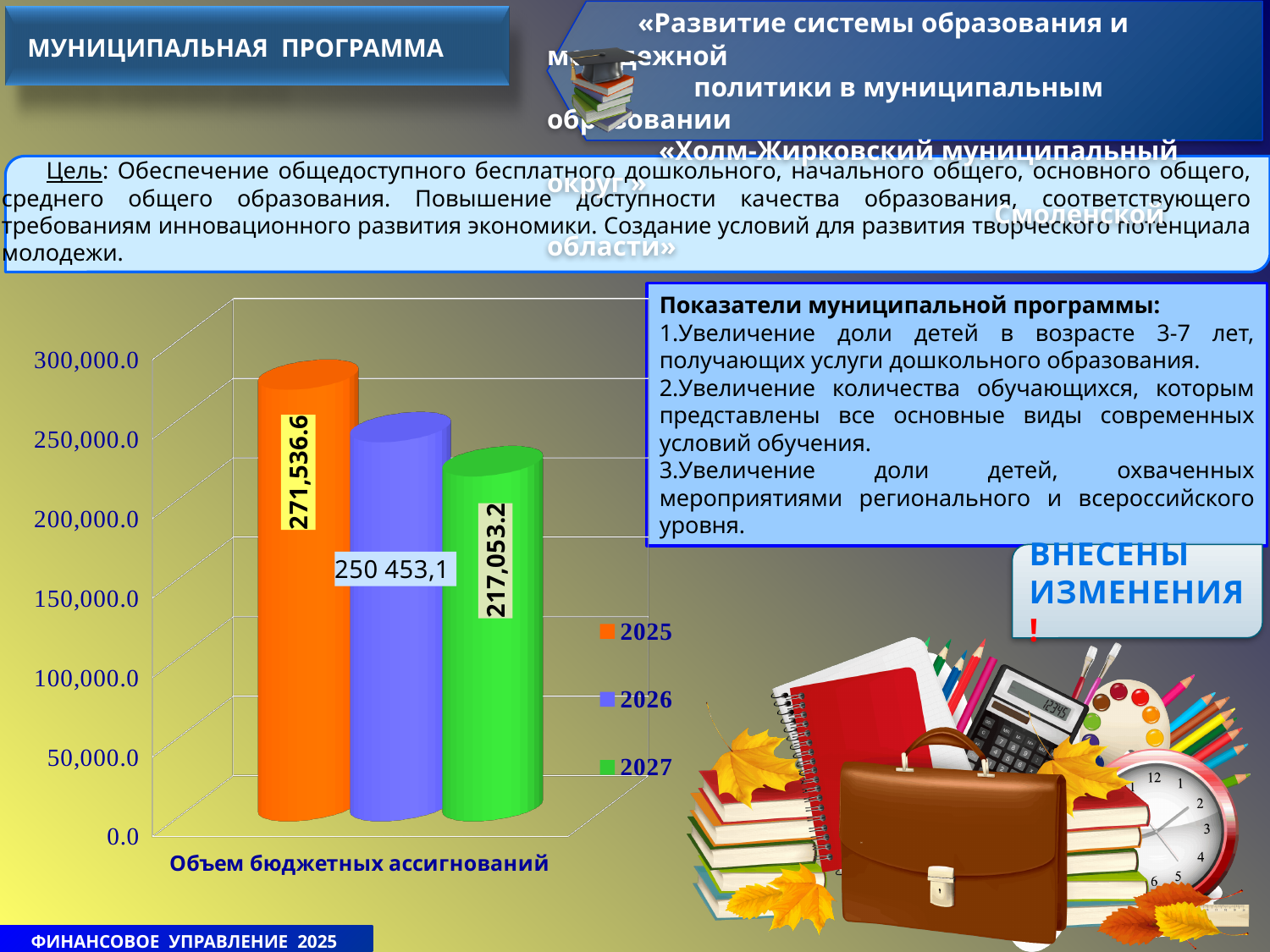
What kind of chart is shown on the slide? bar chart What is the value for 2025 in the chart? 271,536.6 Which is larger, the value for 2026 or the value for 2027? 2026 Do the values rise or fall from 2025 to 2027? fall What is the difference between the values for 2025 and 2026? 21,083.5 What is the difference between the values for 2025 and 2027? 54,483.4 What is the value for 2027 in the chart? 217,053.2 What is the value for 2026 in the chart? 250 453,1 How many series does the legend list? 3 Is the value for 2027 greater or less than 200,000.0? greater Which year has the lowest value in the chart? 2027 Which year has the highest value in the chart? 2025